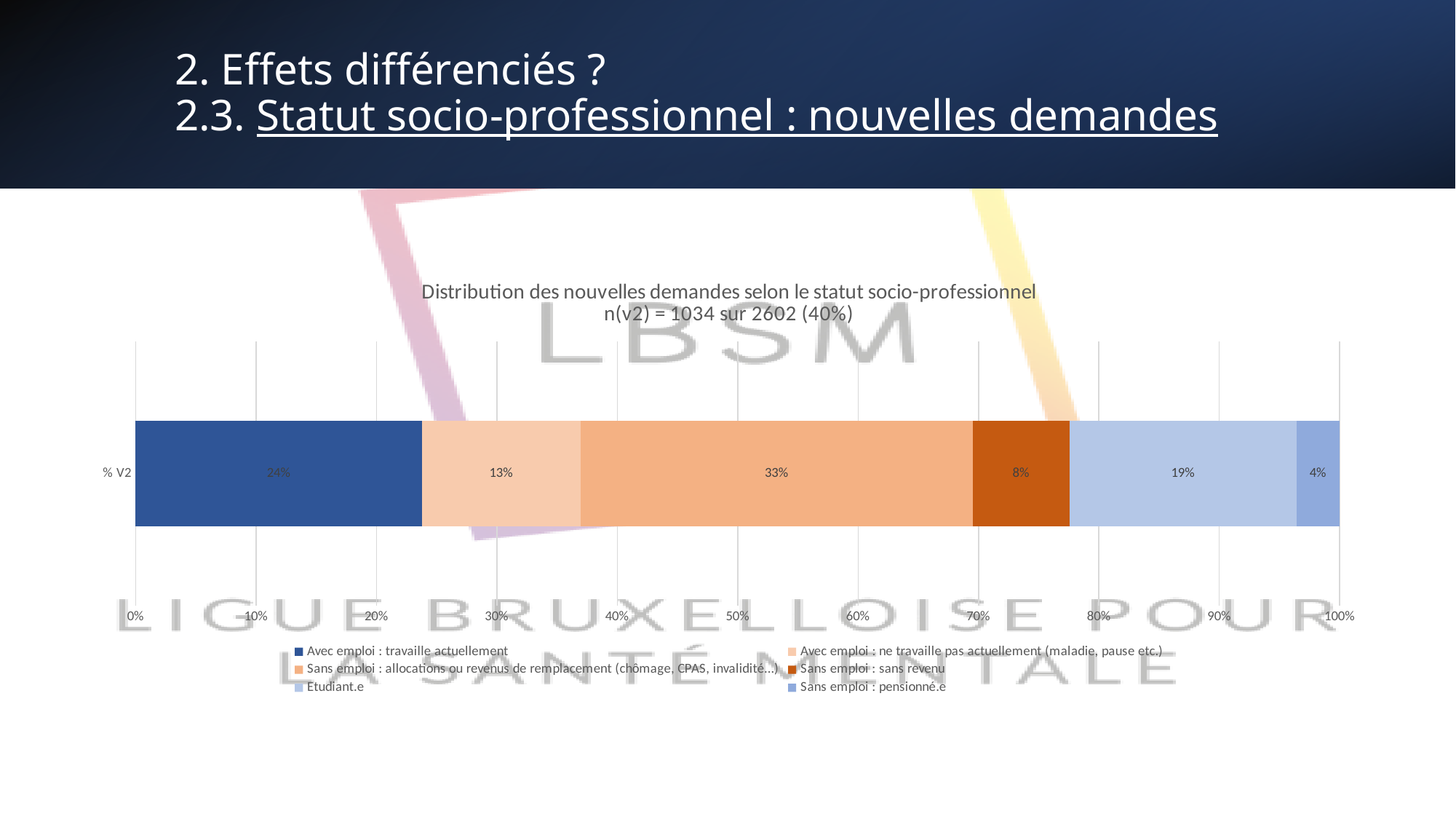
How many series does the legend list? 6 Which is larger, the value for "Etudiant.e" or the value for "Avec emploi : ne travaille pas actuellement (maladie, pause etc.)"? Etudiant.e Which series has the largest share of the bar? Sans emploi : allocations ou revenus de remplacement (chômage, CPAS, invalidité...) Which series has the smallest share of the bar? Sans emploi : pensionné.e What is the value for "Etudiant.e"? 19% What is the difference between the values for "Avec emploi : travaille actuellement" and "Avec emploi : ne travaille pas actuellement (maladie, pause etc.)"? 11% What is the value for "Sans emploi : sans revenu"? 8% What is the value for "Avec emploi : travaille actuellement"? 24% What kind of chart is shown on the slide? Stacked bar chart What is the title of the chart? Distribution des nouvelles demandes selon le statut socio-professionnel n(v2) = 1034 sur 2602 (40%) What is the value for "Sans emploi : allocations ou revenus de remplacement (chômage, CPAS, invalidité...)"? 33% What is the value for "Sans emploi : pensionné.e"? 4%